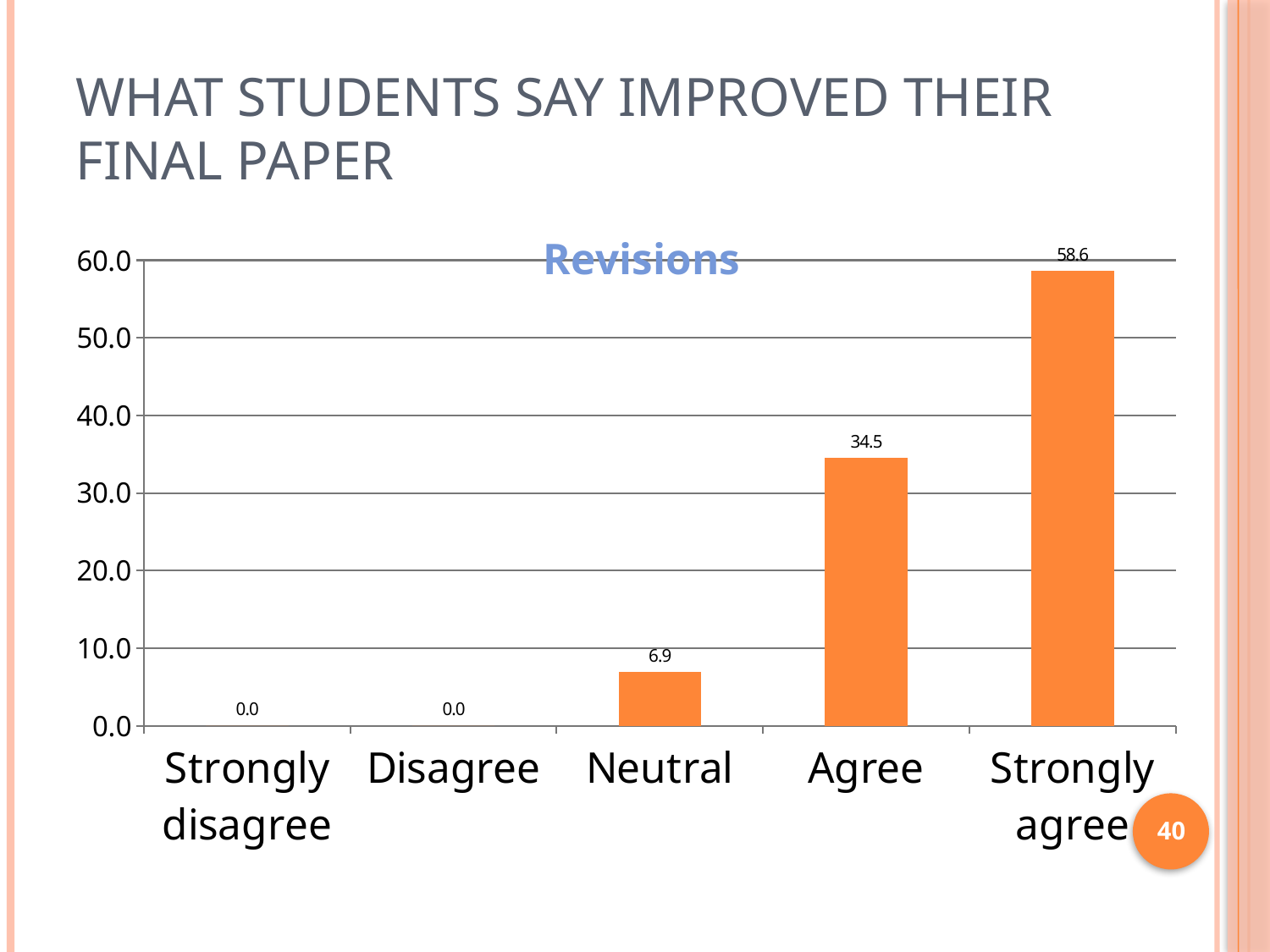
What is the value for Neutral? 6.9 What is the value for Disagree? 0.0 What is the value for Strongly agree? 58.6 How many categories are shown on the x axis? 5 Do the values rise or fall from Strongly disagree to Strongly agree? rise Is the value for Agree greater or less than 30.0? greater Which category has the highest value? Strongly agree What is the value for Agree? 34.5 Which is larger, the value for Agree or the value for Neutral? Agree What is the difference between the values for Strongly agree and Agree? 24.1 What kind of chart is shown? bar chart What is the title of the chart? Revisions